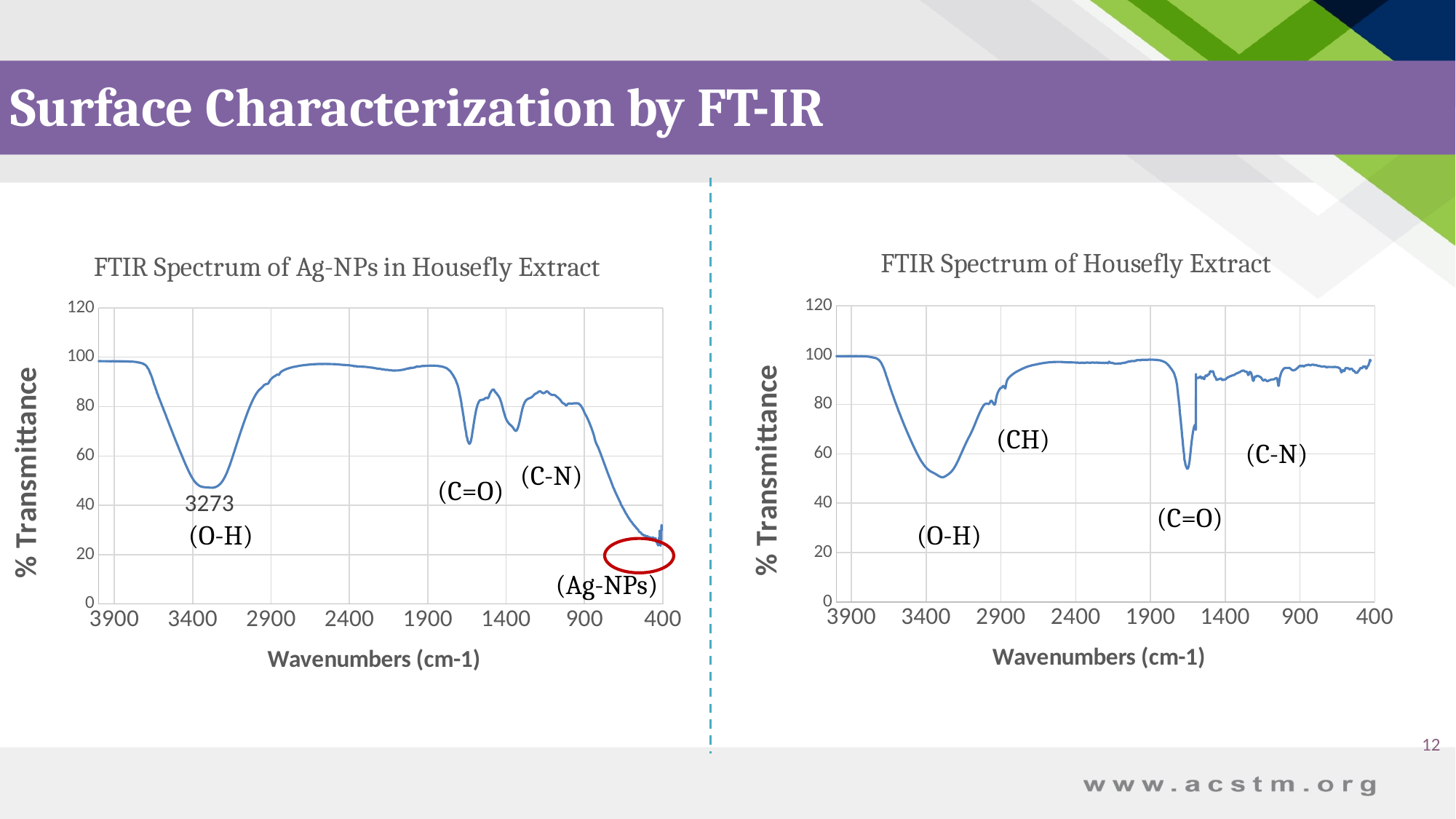
What is the title of the right chart? FTIR Spectrum of Housefly Extract At 400 cm-1, which chart shows the higher % transmittance, the left chart or the right chart? the right chart In the left chart, which annotation is circled in red? (Ag-NPs) In the right chart, does the % transmittance rise or fall as the wavenumber goes from 3900 to 3400 cm-1? fall In the left chart, what wavenumber is printed next to the (O-H) band? 3273 In the right chart, is the lowest % transmittance of the (C=O) dip greater or less than 40? greater In the left chart, is the % transmittance at 400 cm-1 greater or less than 40? less What kind of chart is the left chart, 'FTIR Spectrum of Ag-NPs in Housefly Extract'? line chart In the right chart, is the % transmittance at 400 cm-1 greater or less than 80? greater